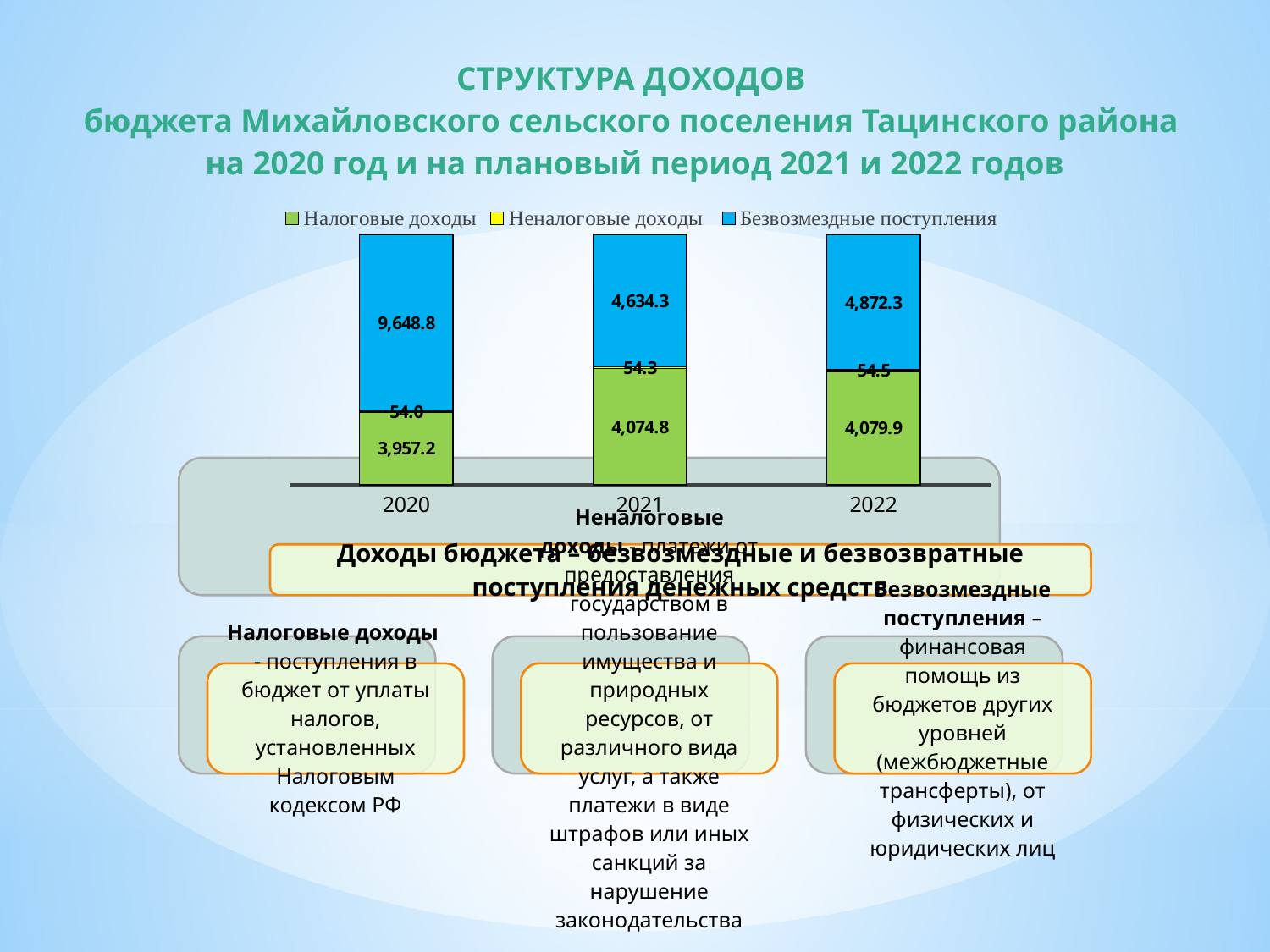
What is the value of Безвозмездные поступления for 2020? 9,648.8 What is the value of Неналоговые доходы for 2022? 54.5 What is the value of Налоговые доходы for 2021? 4,074.8 How many years (categories) are shown on the x axis? 3 What is the total of the stacked bar for 2021? 8,763.4 Which colour represents Неналоговые доходы in the legend? yellow What is the difference between Безвозмездные поступления in 2020 and in 2021? 5,014.5 Which is larger: Налоговые доходы in 2020 or Безвозмездные поступления in 2020? Безвозмездные поступления in 2020 How many series does the legend list? 3 In which year is the value of Налоговые доходы the lowest? 2020 What type of chart is shown on the slide? stacked bar chart In which year is the value of Безвозмездные поступления the highest? 2020